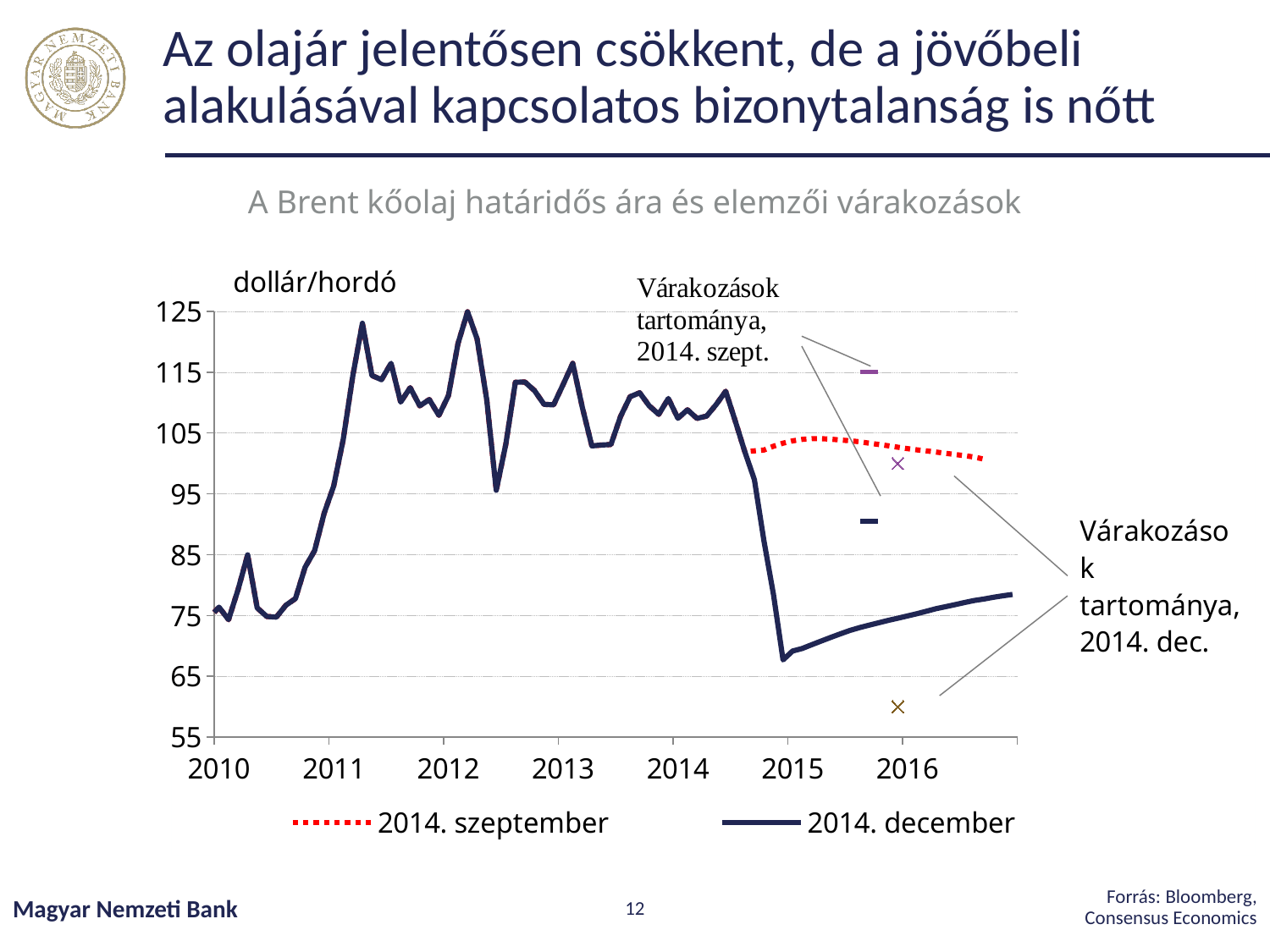
Is the peak of the 2014. december series in early 2012 greater or less than 115? greater What is the first year label shown on the horizontal axis? 2010 Is the value of the 2014. december series at the start of 2015 greater or less than 75? less Is the value of the 2014. szeptember series at 2015 greater or less than 95? greater What are the two series named in the chart legend? 2014. szeptember and 2014. december What kind of chart is shown on the slide? line chart At 2016, which series is higher, 2014. szeptember or 2014. december? 2014. szeptember Between mid-2014 and the start of 2015, does the 2014. december series rise or fall? fall How many series does the chart legend list? 2 From the start of 2015 to the end of the 2014. december series, does the line rise or fall? rise What unit is shown on the vertical axis of the chart? dollár/hordó